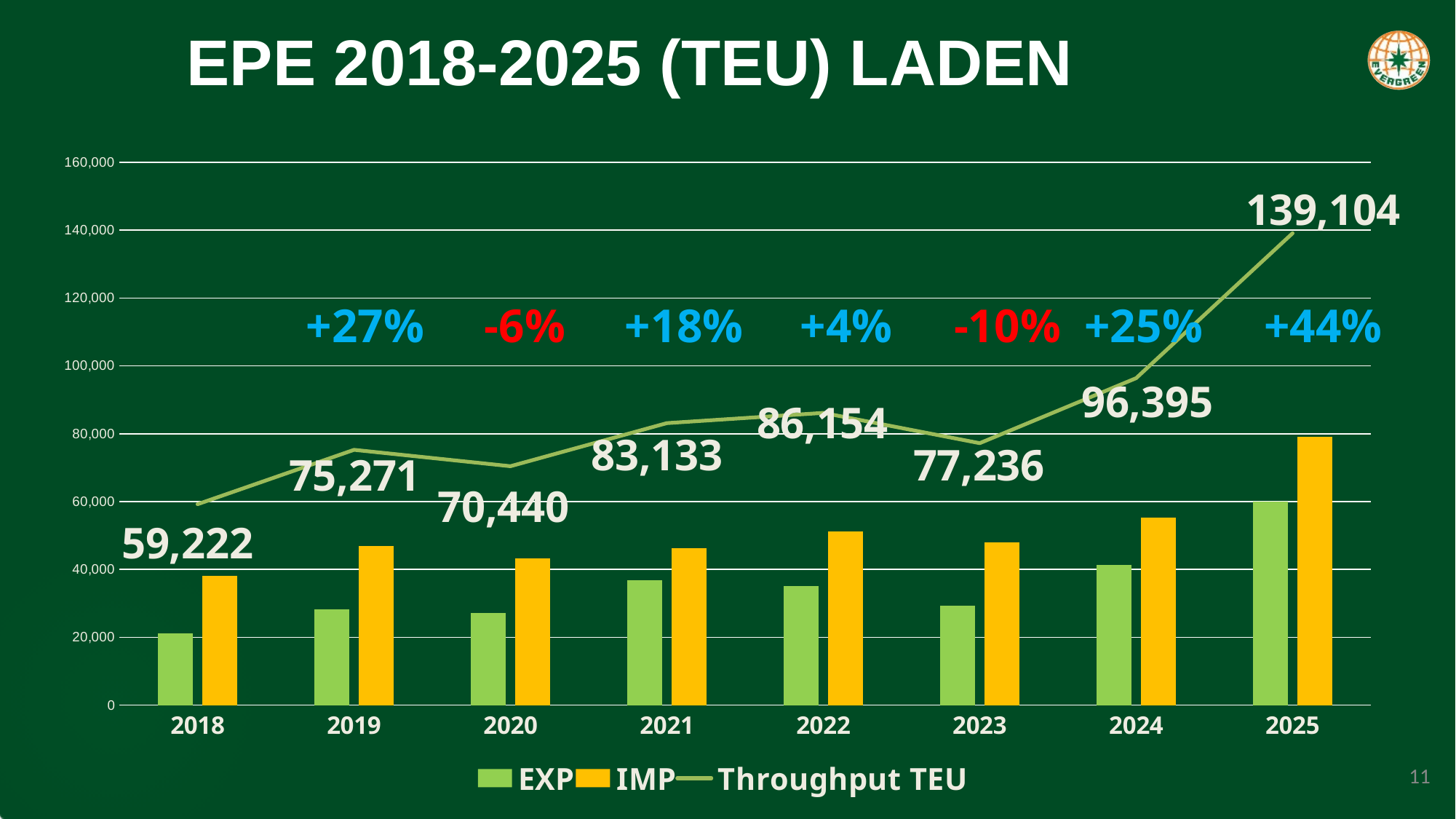
Which is larger, the Throughput TEU for 2022 or for 2023? 2022 What is the Throughput TEU value for 2025? 139,104 Is the IMP value for 2024 greater or less than 60,000? less Which year has the highest Throughput TEU? 2025 What is the Throughput TEU value for 2018? 59,222 How many series does the legend list? 3 How many years are shown on the x axis? 8 What percentage change is shown for 2025? +44% What is the difference in Throughput TEU between 2025 and 2024? 42,709 What is the Throughput TEU value for 2023? 77,236 In 2025, which bar is taller, EXP or IMP? IMP Which year has the lowest Throughput TEU? 2018